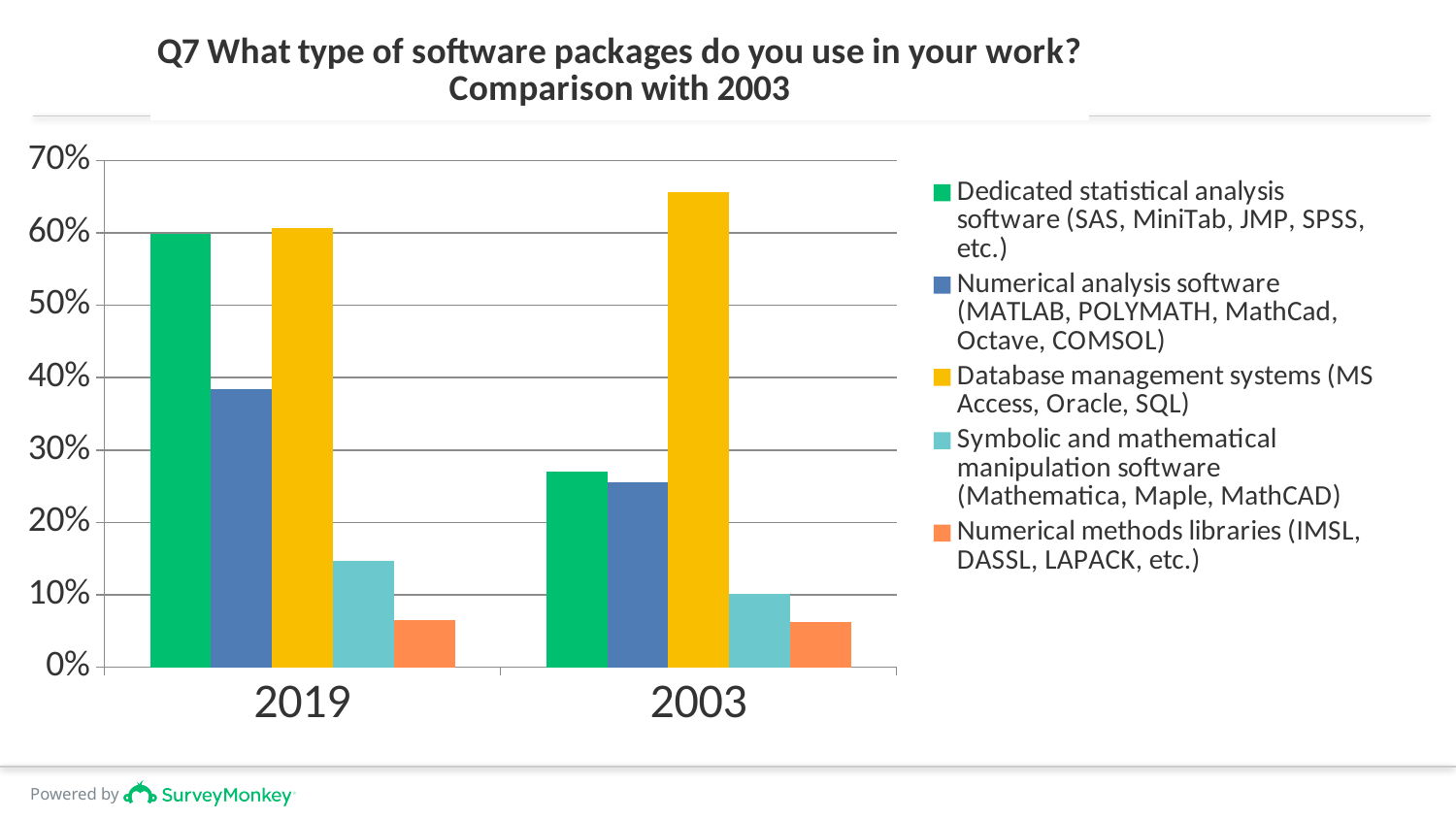
Which software type has the lowest value for 2019? Numerical methods libraries (IMSL, DASSL, LAPACK, etc.) Which is larger for Dedicated statistical analysis software: the 2019 value or the 2003 value? 2019 What colour represents Database management systems in the chart? yellow Is the value for Numerical analysis software in 2019 greater or less than 30%? greater What kind of chart is shown on the slide? bar chart Is the value for Symbolic and mathematical manipulation software in 2019 greater or less than 10%? greater Which software type has the highest value for 2003? Database management systems (MS Access, Oracle, SQL) How many series does the legend list? 5 How many categories are shown on the x axis? 2 Is the value for Dedicated statistical analysis software in 2003 greater or less than 30%? less Which software type has the lowest value for 2003? Numerical methods libraries (IMSL, DASSL, LAPACK, etc.)